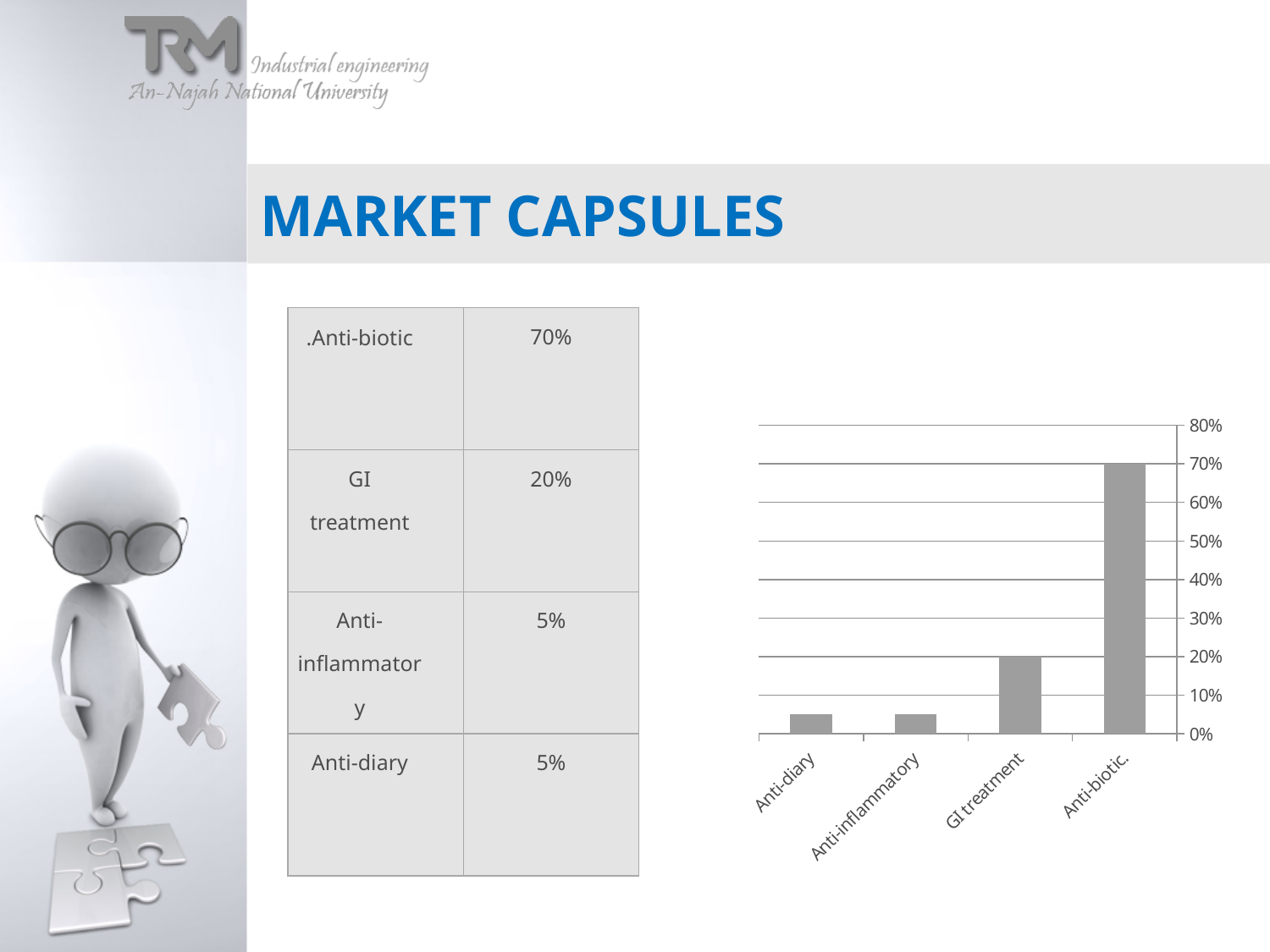
What is the value for Anti-diary? 5% Which is larger, the value for GI treatment or the value for Anti-diary? GI treatment What is the value for Anti-inflammatory? 5% What is the difference between the values for Anti-biotic and GI treatment? 50% What is the value for Anti-biotic? 70% What is the value for GI treatment? 20% Is the value for Anti-biotic greater or less than 60%? greater Do the bar values rise or fall from left to right along the x axis? rise What kind of chart is shown on the slide? bar chart Is the value for Anti-diary greater or less than 10%? less How many categories are plotted in the bar chart? 4 Which category has the highest value in the bar chart? Anti-biotic